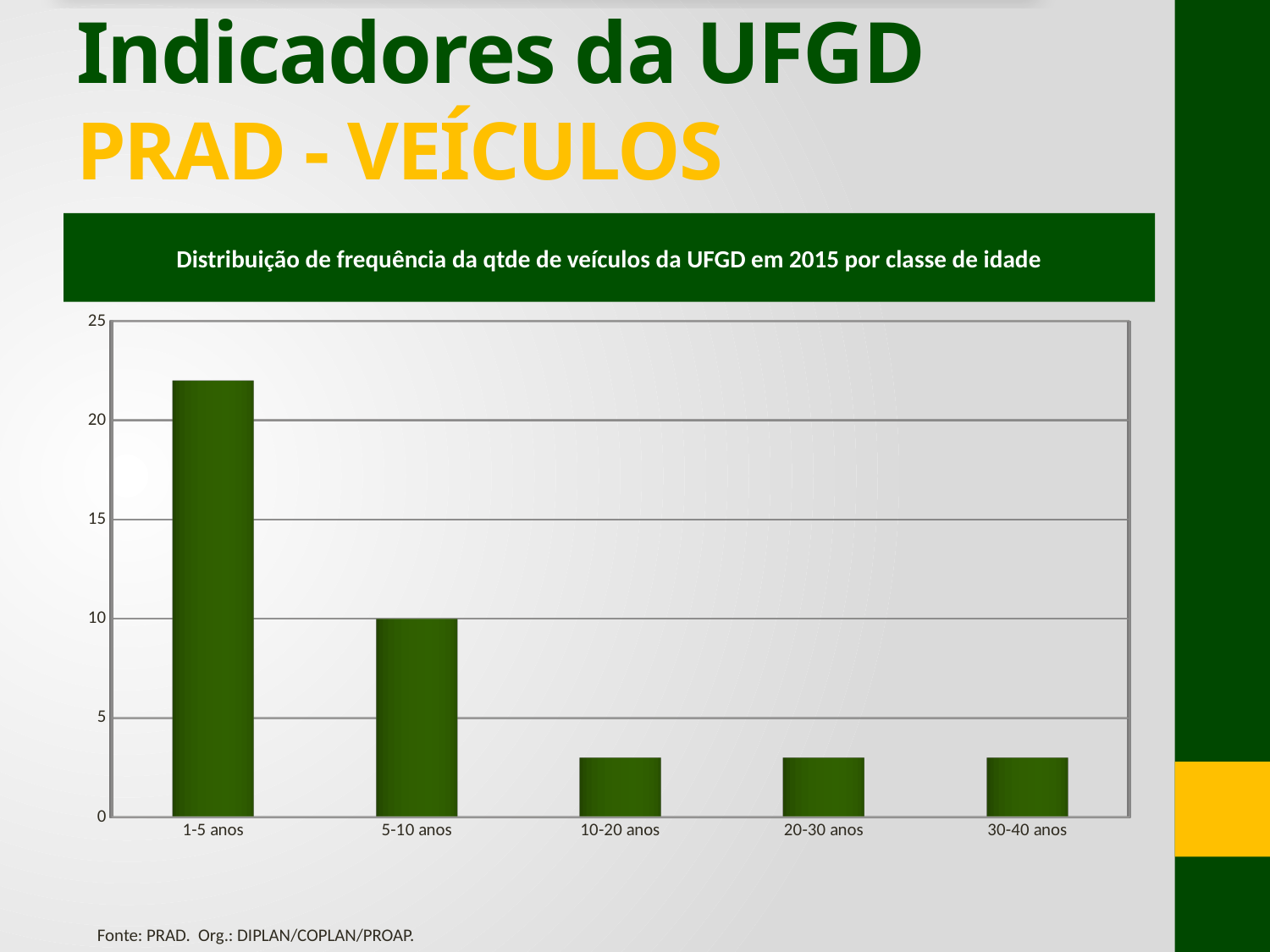
How many age classes (categories) are shown on the x axis of the chart? 5 Is the value for 1-5 anos greater or less than 25? less Is the value for 30-40 anos greater or less than 5? less Is the value for 1-5 anos greater or less than 20? greater Which is larger, the value for 1-5 anos or the value for 5-10 anos? 1-5 anos Which age class has the highest number of vehicles in the chart? 1-5 anos Do the values generally rise or fall moving from left to right along the x axis? fall What is the value for the 5-10 anos category? 10 Which is larger, the value for 5-10 anos or the value for 20-30 anos? 5-10 anos What type of chart is shown on the slide? bar chart What is the title of the chart? Distribuição de frequência da qtde de veículos da UFGD em 2015 por classe de idade